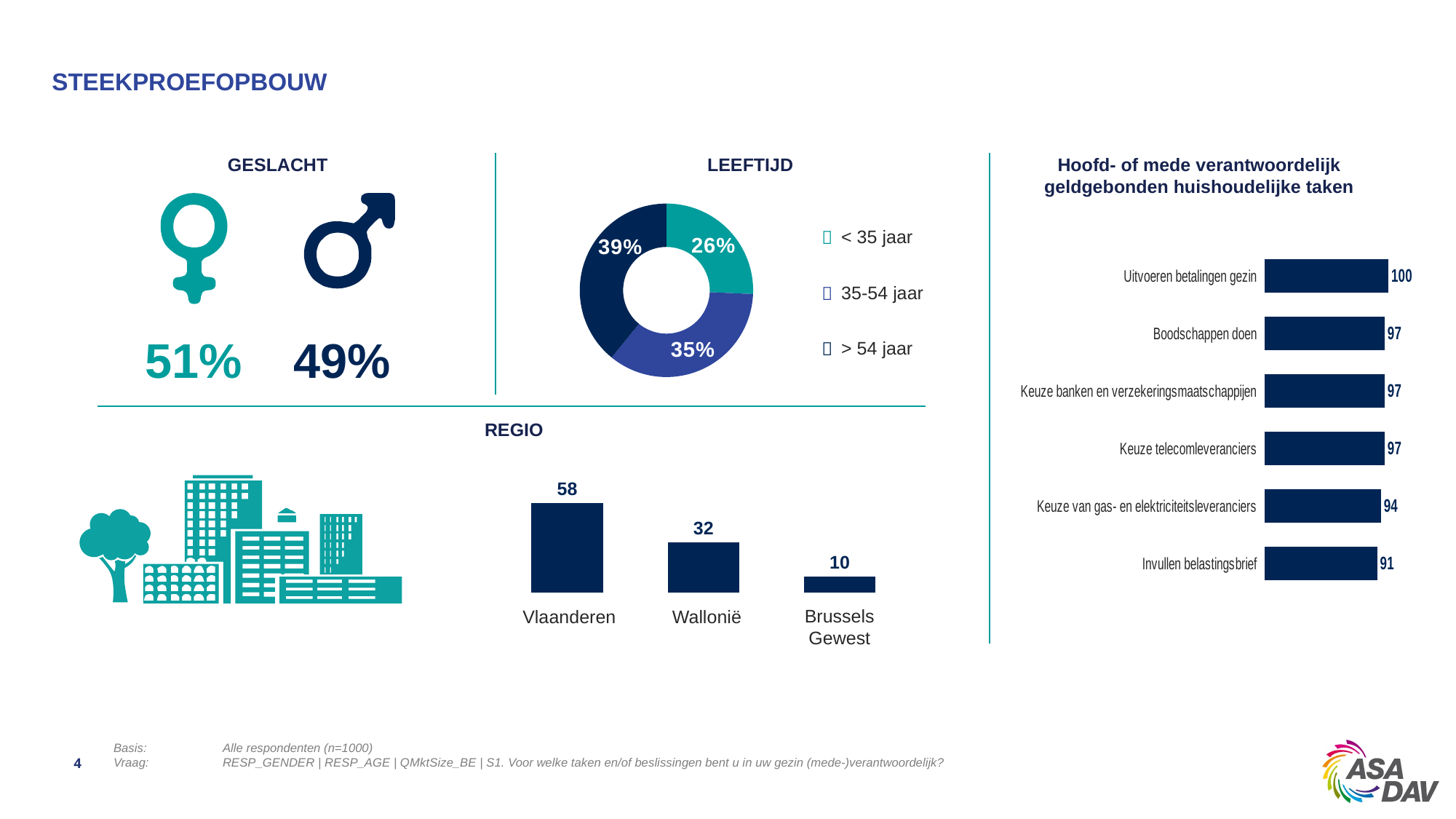
What kind of chart is the LEEFTIJD chart? Donut chart In the 'Hoofd- of mede verantwoordelijk geldgebonden huishoudelijke taken' chart, what is the value for Invullen belastingsbrief? 91 In the 'Hoofd- of mede verantwoordelijk geldgebonden huishoudelijke taken' chart, which task has the highest value? Uitvoeren betalingen gezin In the LEEFTIJD chart, which age group has the largest share? > 54 jaar In the REGIO chart, how many regions are shown? 3 In the REGIO chart, what is the value for Wallonië? 32 In the REGIO chart, what is the difference between Vlaanderen and Wallonië? 26 In the LEEFTIJD chart, what is the difference in percentage points between the > 54 jaar and < 35 jaar groups? 13 In the 'Hoofd- of mede verantwoordelijk geldgebonden huishoudelijke taken' chart, how many tasks are listed? 6 In the LEEFTIJD chart, what percentage of respondents are younger than 35 (< 35 jaar)? 26% In the REGIO chart, which region has the lowest value? Brussels Gewest How many age groups does the LEEFTIJD chart legend list? 3